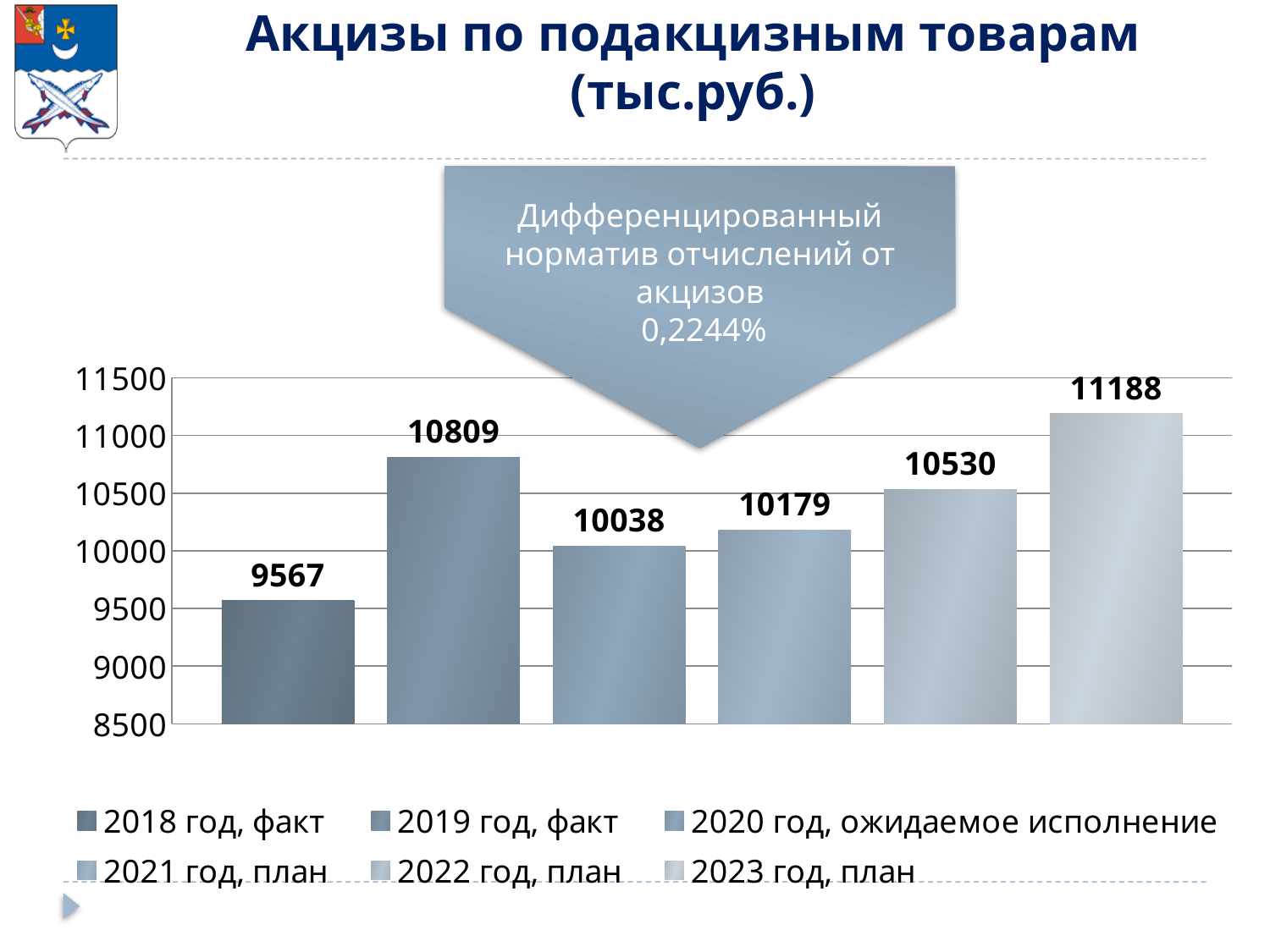
Which year has the lowest value? 2018 год, факт What is the difference between the values for 2023 год, план and 2022 год, план? 658 What is the value for 2023 год, план? 11188 What is the value for 2018 год, факт? 9567 How many entries does the legend list? 6 Is the value for 2022 год, план greater or less than 10500? greater Which is larger, the value for 2019 год, факт or the value for 2021 год, план? 2019 год, факт Which year has the highest value? 2023 год, план How many bars are shown in the chart? 6 What kind of chart is shown on the slide? bar chart What is the difference between the values for 2019 год, факт and 2018 год, факт? 1242 What is the value for 2020 год, ожидаемое исполнение? 10038